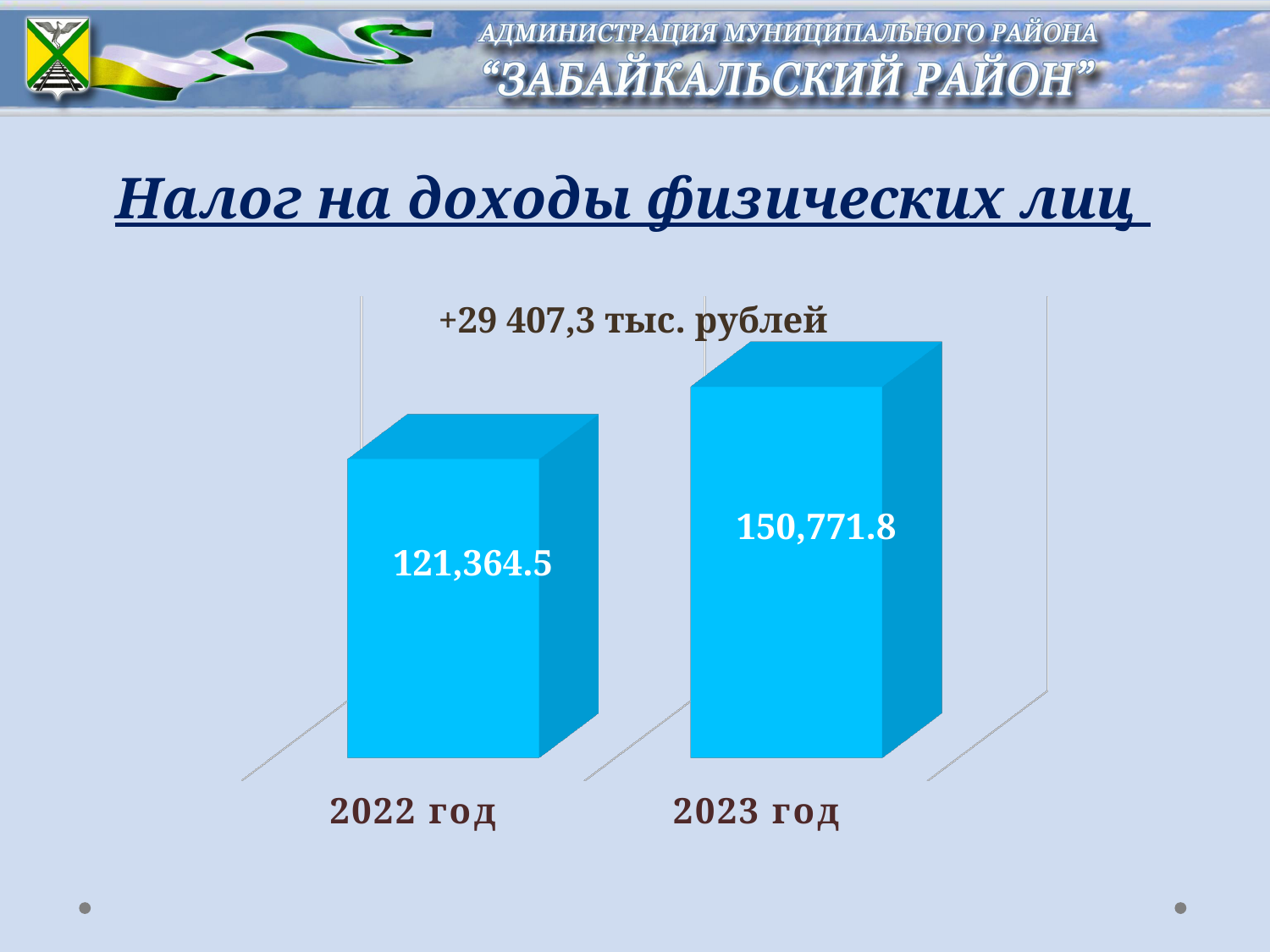
Which is larger, the value for 2022 год or 2023 год? 2023 год What is the value for 2022 год? 121,364.5 What increase is annotated above the bars? +29 407,3 тыс. рублей Do the values rise or fall from 2022 год to 2023 год? Rise What is the difference between the values for 2023 год and 2022 год? 29,407.3 How many categories are shown in the chart? 2 What is the title of the slide above the chart? Налог на доходы физических лиц What is the value for 2023 год? 150,771.8 Which year has the highest value? 2023 год Which year has the lowest value? 2022 год What kind of chart is shown on the slide? Bar chart